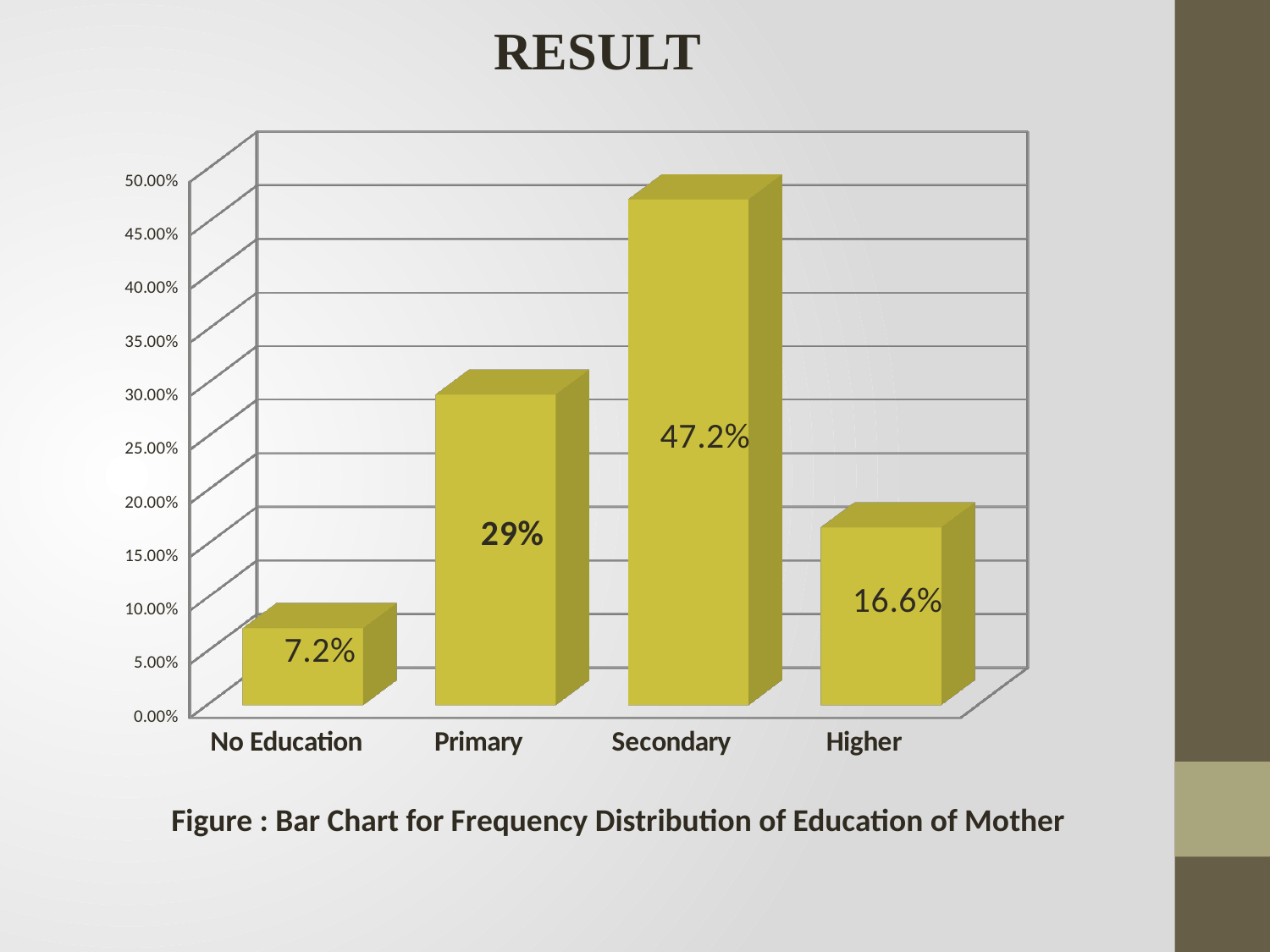
Which is larger, the value for Primary or the value for Higher? Primary What is the value for Secondary? 47.2% Which category has the lowest value? No Education Which category has the highest value? Secondary What is the value for Primary? 29% What is the caption of the figure shown below the chart? Figure : Bar Chart for Frequency Distribution of Education of Mother How many categories are shown on the x axis? 4 What is the difference between the values for Higher and No Education? 9.4% What kind of chart is shown on the slide? Bar chart What is the difference between the values for Secondary and Primary? 18.2% What is the value for No Education? 7.2% What is the value for Higher? 16.6%